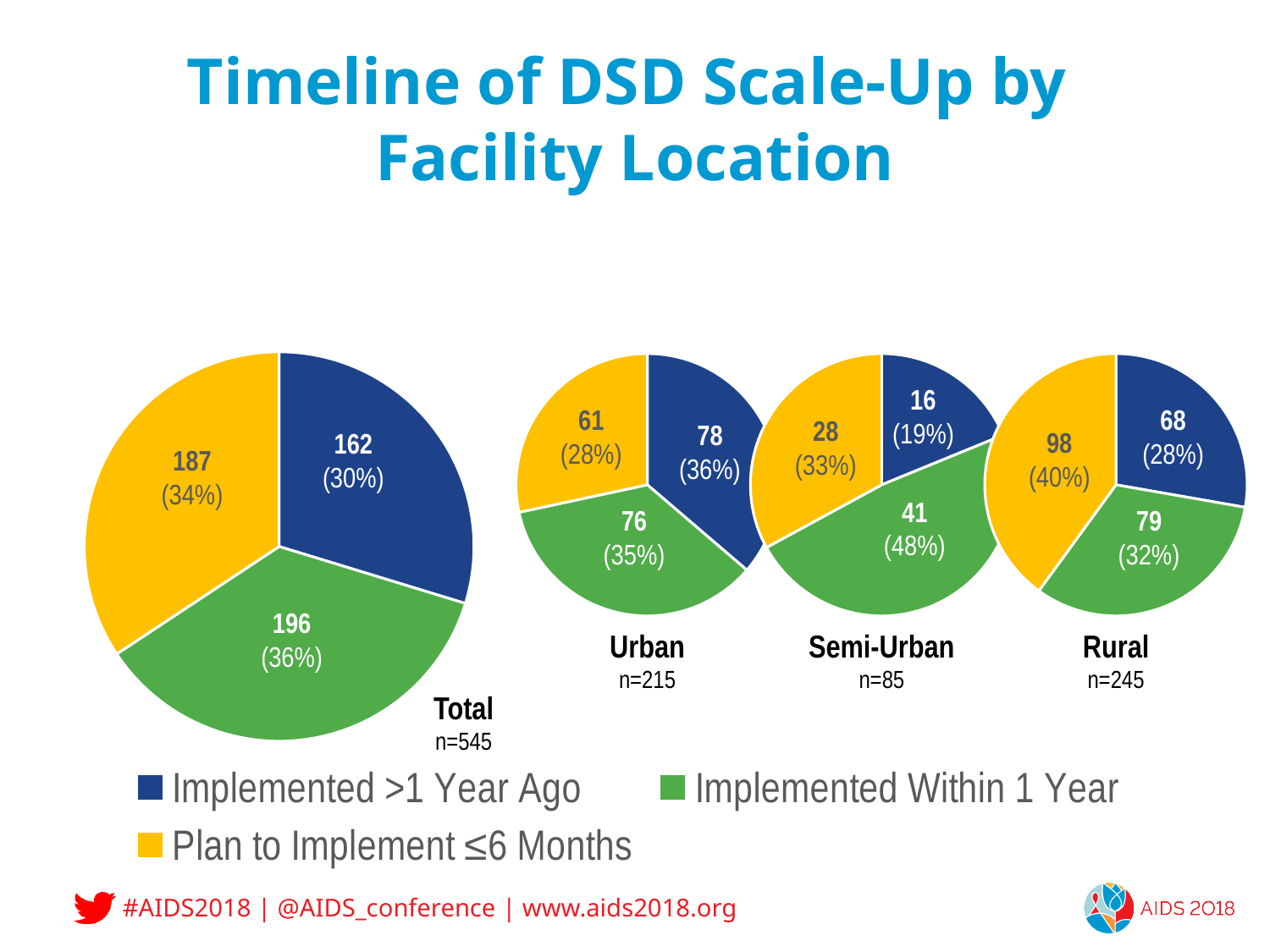
How many pie charts are on the slide? 4 In the Semi-Urban pie chart, which category has the largest slice? Implemented Within 1 Year In the Rural pie chart, what is the difference between the Implemented Within 1 Year value and the Implemented >1 Year Ago value? 11 What is the sample size (n) shown for the Semi-Urban pie chart? n=85 In the Urban pie chart, what is the value for Implemented Within 1 Year? 76 In the Rural pie chart, what share of facilities plan to implement DSD within 6 months? 40% What kind of charts are shown on the slide? Pie charts How many series does the legend list? 3 In the Total pie chart, what share of facilities plan to implement DSD within 6 months? 34% In the Semi-Urban pie chart, which category has the smallest slice? Implemented >1 Year Ago In the Total pie chart, how many facilities implemented DSD more than 1 year ago? 162 In the Urban pie chart, is the value for Implemented >1 Year Ago larger or smaller than the value for Plan to Implement ≤6 Months? larger